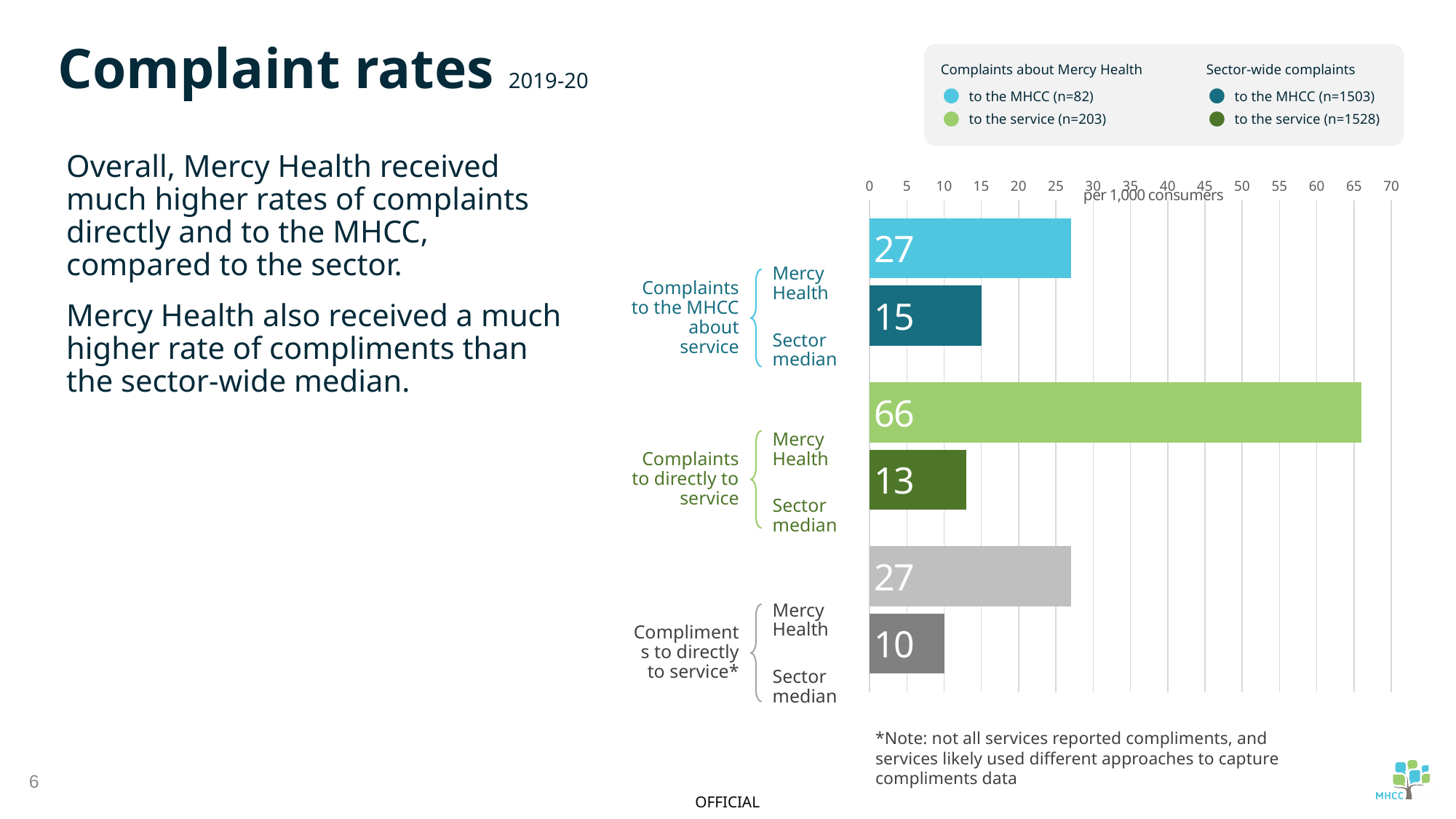
What is the rate of complaints made directly to service for Mercy Health? 66 How many bars are plotted on the chart? 6 What type of chart is shown on the slide? Bar chart Which bar has the highest value on the chart? Mercy Health, complaints to directly to service (66) What is the sector median rate of compliments made directly to service? 10 Which is larger: Mercy Health's rate of compliments directly to service or the sector median rate of compliments directly to service? Mercy Health What is the sector median rate of complaints to the MHCC about service? 15 Which bar has the lowest value on the chart? Sector median, compliments to directly to service (10) What is the difference between Mercy Health's rate of complaints to the MHCC about service and the sector median? 12 What unit does the chart's axis label say the values are measured in? per 1,000 consumers What is the difference between Mercy Health's rate of complaints directly to service and the sector median? 53 What is the rate of complaints to the MHCC about service for Mercy Health? 27